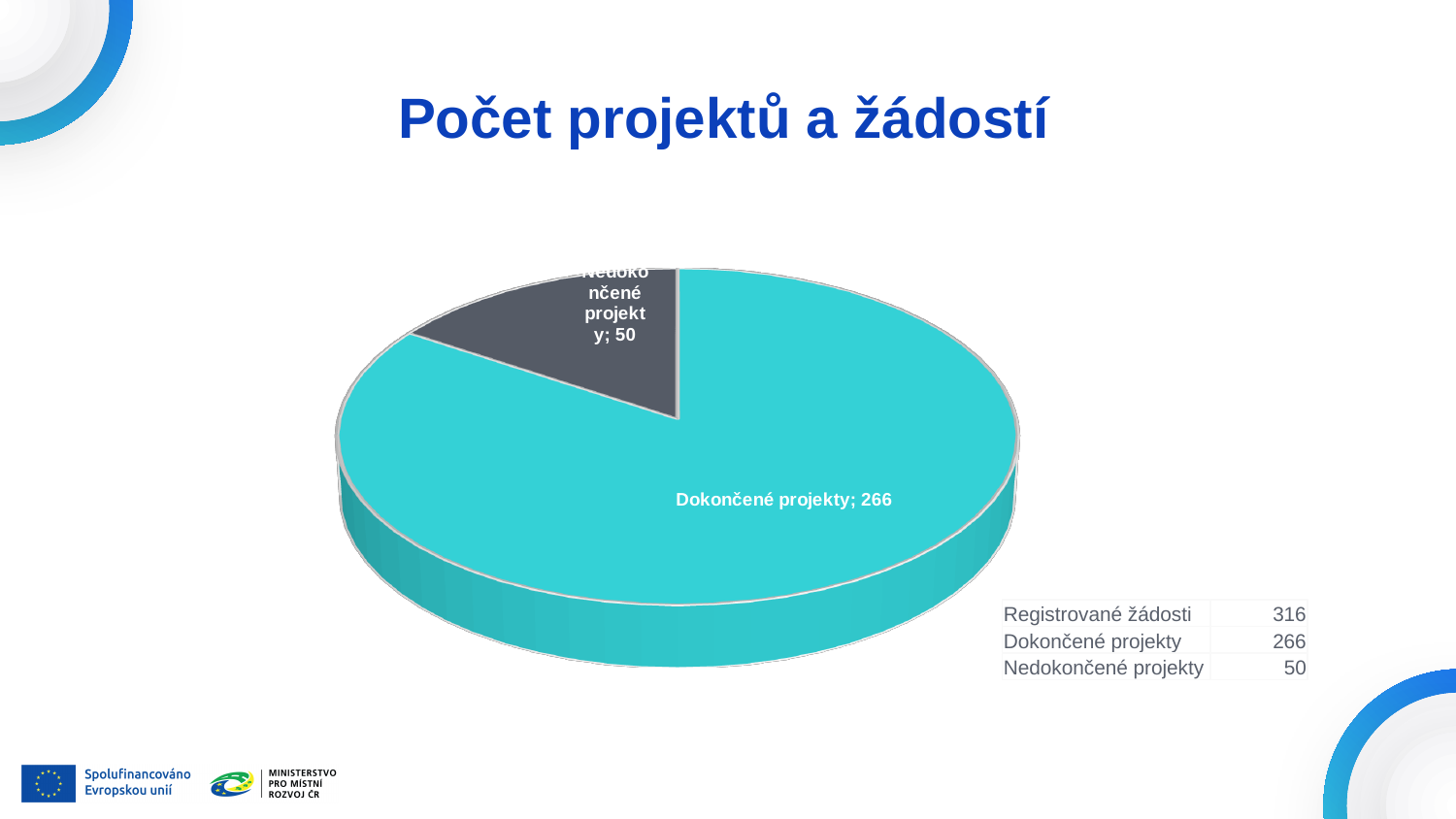
What is the value for Nedokončené projekty in the pie chart? 50 Which slice of the pie chart is the largest? Dokončené projekty According to the table next to the chart, what is the value for Registrované žádosti? 316 What is the title of the slide containing the pie chart? Počet projektů a žádostí What is the total of the two slices in the pie chart? 316 How many slices does the pie chart have? 2 What type of chart is shown on the slide? pie chart Which slice of the pie chart is the smallest? Nedokončené projekty Which is larger, Dokončené projekty or Nedokončené projekty? Dokončené projekty What is the difference between Dokončené projekty and Nedokončené projekty? 216 What is the value for Dokončené projekty in the pie chart? 266 What colour is the Dokončené projekty slice in the pie chart? turquoise